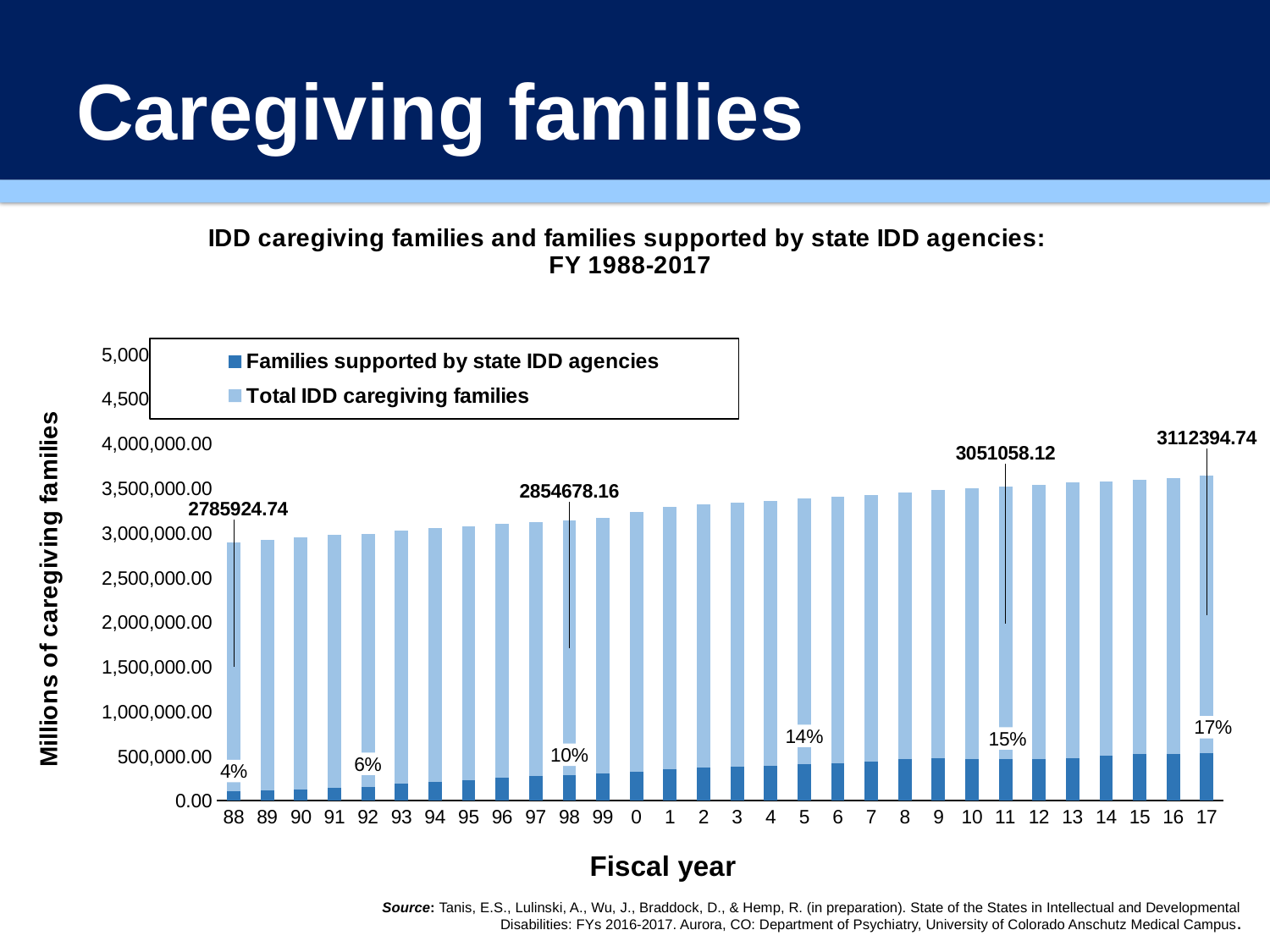
What is the difference between the labelled values for fiscal year 17 (3112394.74) and fiscal year 88 (2785924.74)? 326470.00 What percentage label is shown for fiscal year 17? 17% What is the data label shown on the bar for fiscal year 88? 2785924.74 What is the data label shown on the bar for fiscal year 11? 3051058.12 Is the total height of the stacked bar for fiscal year 17 greater or less than 3,500,000.00? greater What percentage label is shown for fiscal year 88? 4% How many fiscal years are shown on the x axis? 30 What is the data label shown on the bar for fiscal year 17? 3112394.74 How many series does the legend list? 2 Which fiscal year has the shortest stacked bar? 88 Do the stacked bar heights generally rise or fall from fiscal year 88 to 17? rise Which fiscal year has the tallest stacked bar? 17